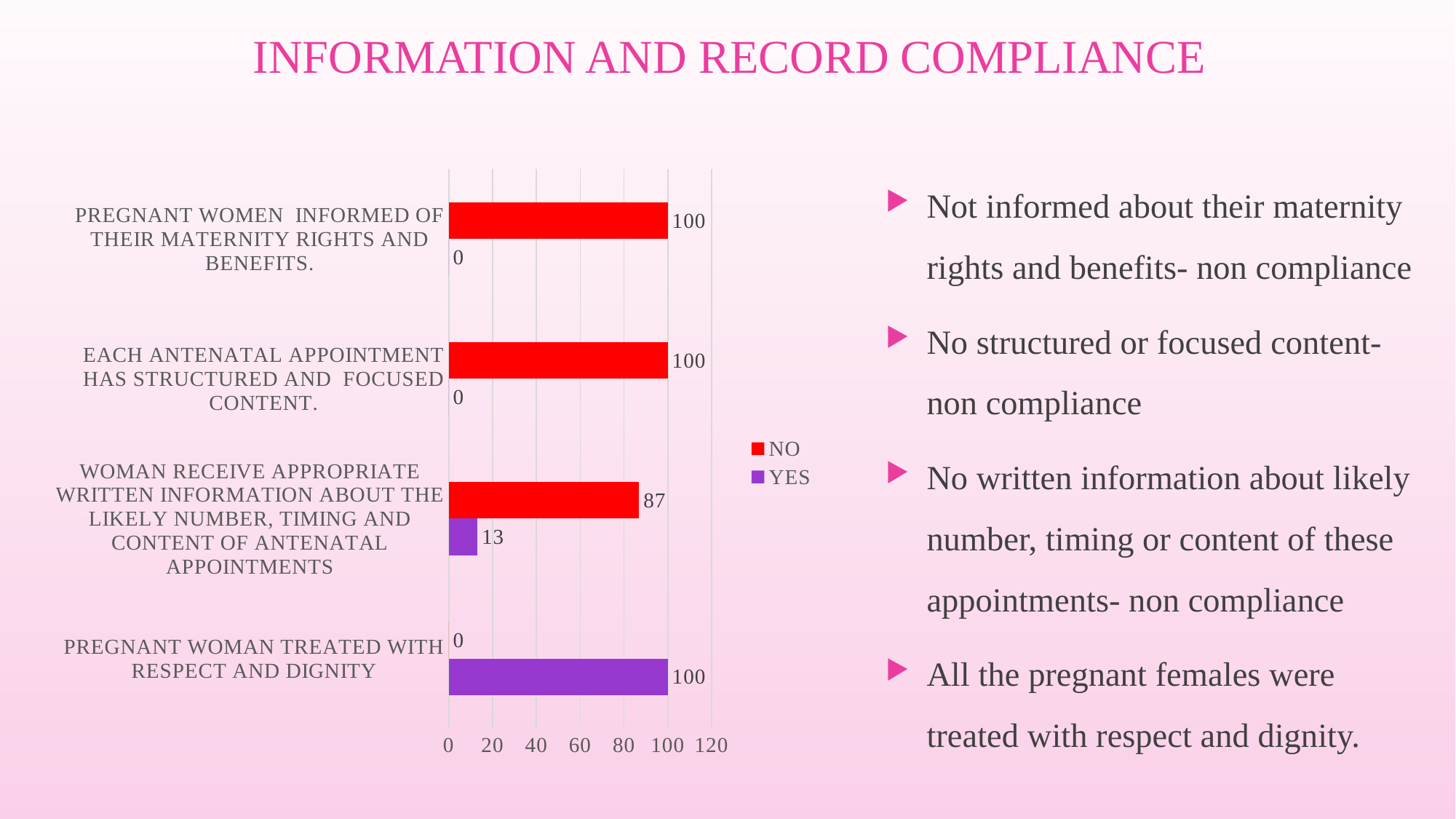
How many categories are shown on the chart? 4 What is the NO value for 'Woman receive appropriate written information about the likely number, timing and content of antenatal appointments'? 87 Which category has the lowest NO value? Pregnant woman treated with respect and dignity What is the YES value for 'Pregnant woman treated with respect and dignity'? 100 What is the NO value for 'Pregnant women informed of their maternity rights and benefits'? 100 Which category has the highest YES value? Pregnant woman treated with respect and dignity What is the YES value for 'Woman receive appropriate written information about the likely number, timing and content of antenatal appointments'? 13 How many series does the legend list? 2 What is the YES value for 'Each antenatal appointment has structured and focused content'? 0 What kind of chart is shown on the slide? Bar chart What is the difference between the NO and YES values for 'Woman receive appropriate written information about the likely number, timing and content of antenatal appointments'? 74 For 'Woman receive appropriate written information about the likely number, timing and content of antenatal appointments', which is larger, the NO value or the YES value? NO